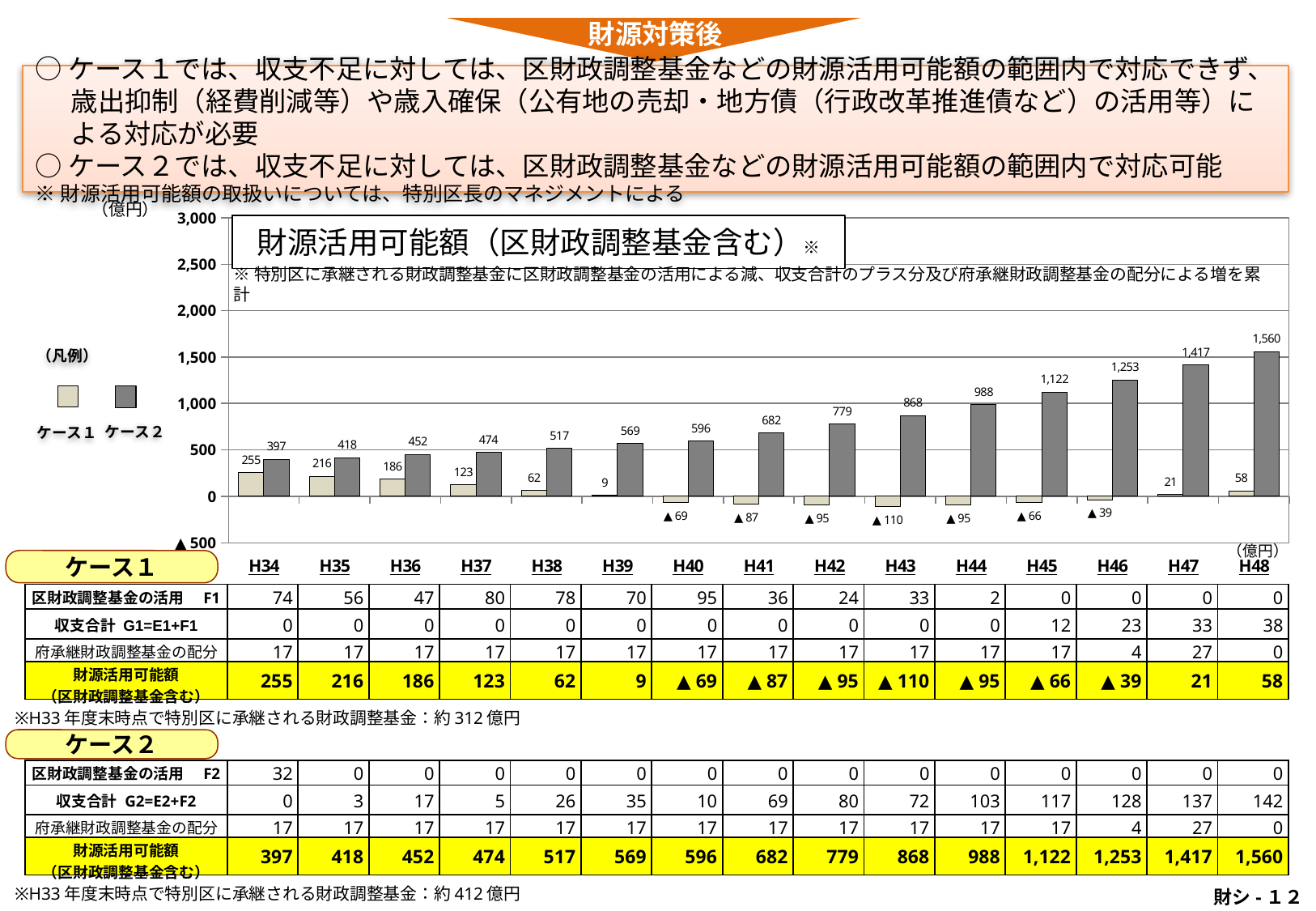
How many years are shown on the x axis of the chart? 15 Which is larger in H39, the value for ケース1 or ケース2? ケース2 Which year has the highest value for ケース2? H48 What kind of chart is shown on the slide? bar chart What is the difference between ケース2 and ケース1 in H34? 142 What is the value for ケース1 in H34? 255 How many series does the legend list? 2 What is the value for ケース2 in H48? 1,560 Which year has the lowest value for ケース1? H43 What is the value for ケース1 in H43? ▲ 110 Is the value for ケース2 in H45 greater or less than 1,000? greater Do the values for ケース2 rise or fall from H34 to H48? rise